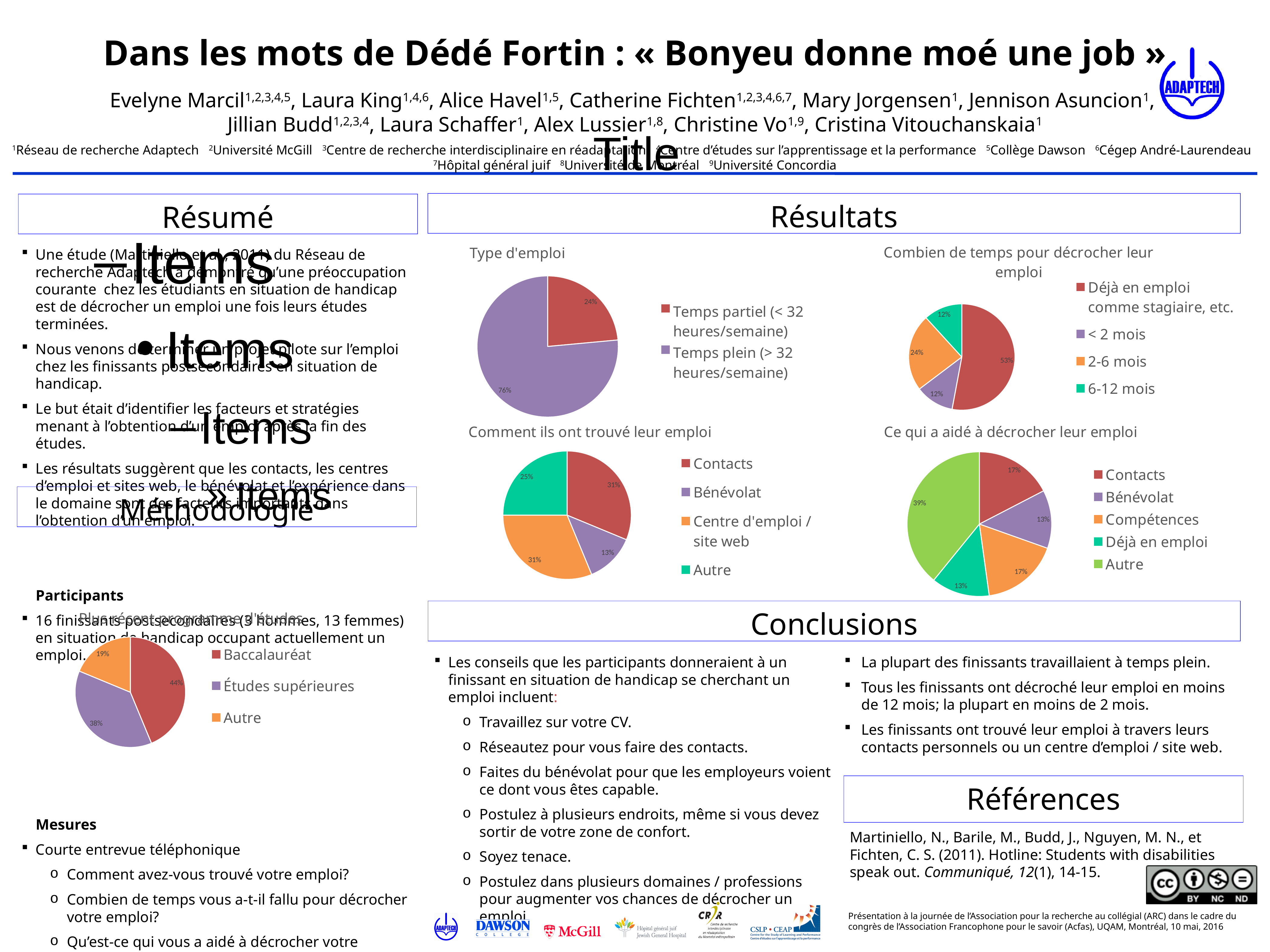
In the 'Combien de temps pour décrocher leur emploi' pie chart, which category has the largest share? Déjà en emploi comme stagiaire, etc. In the pie chart in the lower left of the slide, which is larger: Baccalauréat or Autre? Baccalauréat What kind of chart is used for 'Type d'emploi'? Pie chart In the 'Combien de temps pour décrocher leur emploi' pie chart, what share is 2-6 mois? 24% In the 'Type d'emploi' pie chart, what share is Temps partiel (< 32 heures/semaine)? 24% In the 'Comment ils ont trouvé leur emploi' pie chart, which category has the smallest share? Bénévolat In the 'Ce qui a aidé à décrocher leur emploi' pie chart, what share is Compétences? 17% How many categories does the legend of the 'Combien de temps pour décrocher leur emploi' pie chart list? 4 In the 'Ce qui a aidé à décrocher leur emploi' pie chart, which category has the largest share? Autre In the 'Comment ils ont trouvé leur emploi' pie chart, what is the difference between the Contacts share and the Autre share? 6%